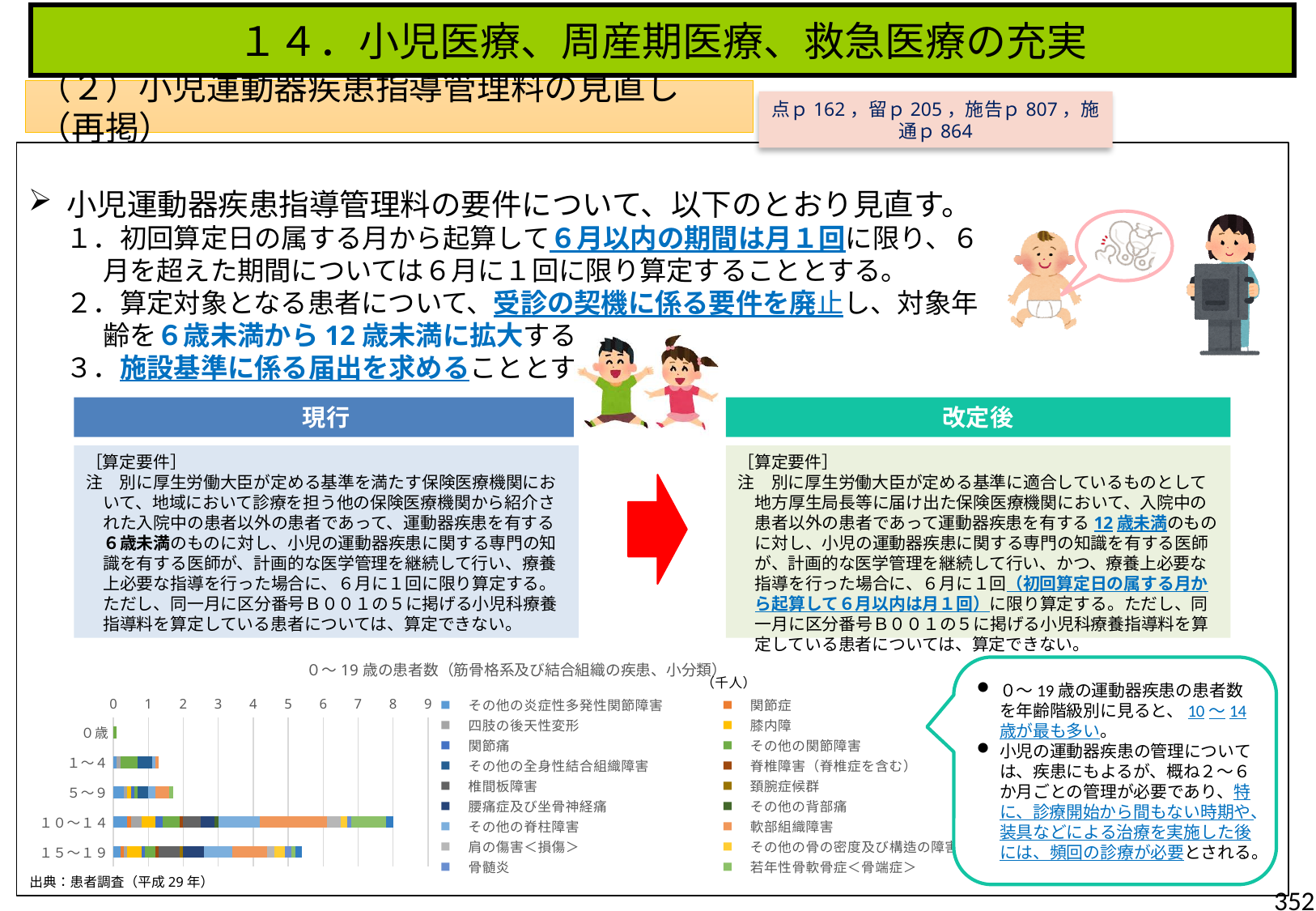
In the chart 「0～19歳の患者数」, is the total for 15～19 greater or less than 7? less What is the source cited below the chart 「0～19歳の患者数」? 患者調査（平成29年） In the chart 「0～19歳の患者数」, which age group has the smallest total number of patients? 0歳 In the chart 「0～19歳の患者数」, is the total for 0歳 greater or less than 1? less What unit is shown for the values in the chart 「0～19歳の患者数」? 千人 How many series does the legend of the chart 「0～19歳の患者数」 list? 18 In the chart 「0～19歳の患者数」, which age group has the largest total number of patients? 10～14 What kind of chart is shown at the bottom left of the slide? Stacked horizontal bar chart In the chart 「0～19歳の患者数」, is the total for 10～14 greater or less than 7? greater How many age categories are plotted in the chart 「0～19歳の患者数」? 5 In the chart 「0～19歳の患者数」, which age group has a larger total: 10～14 or 15～19? 10～14